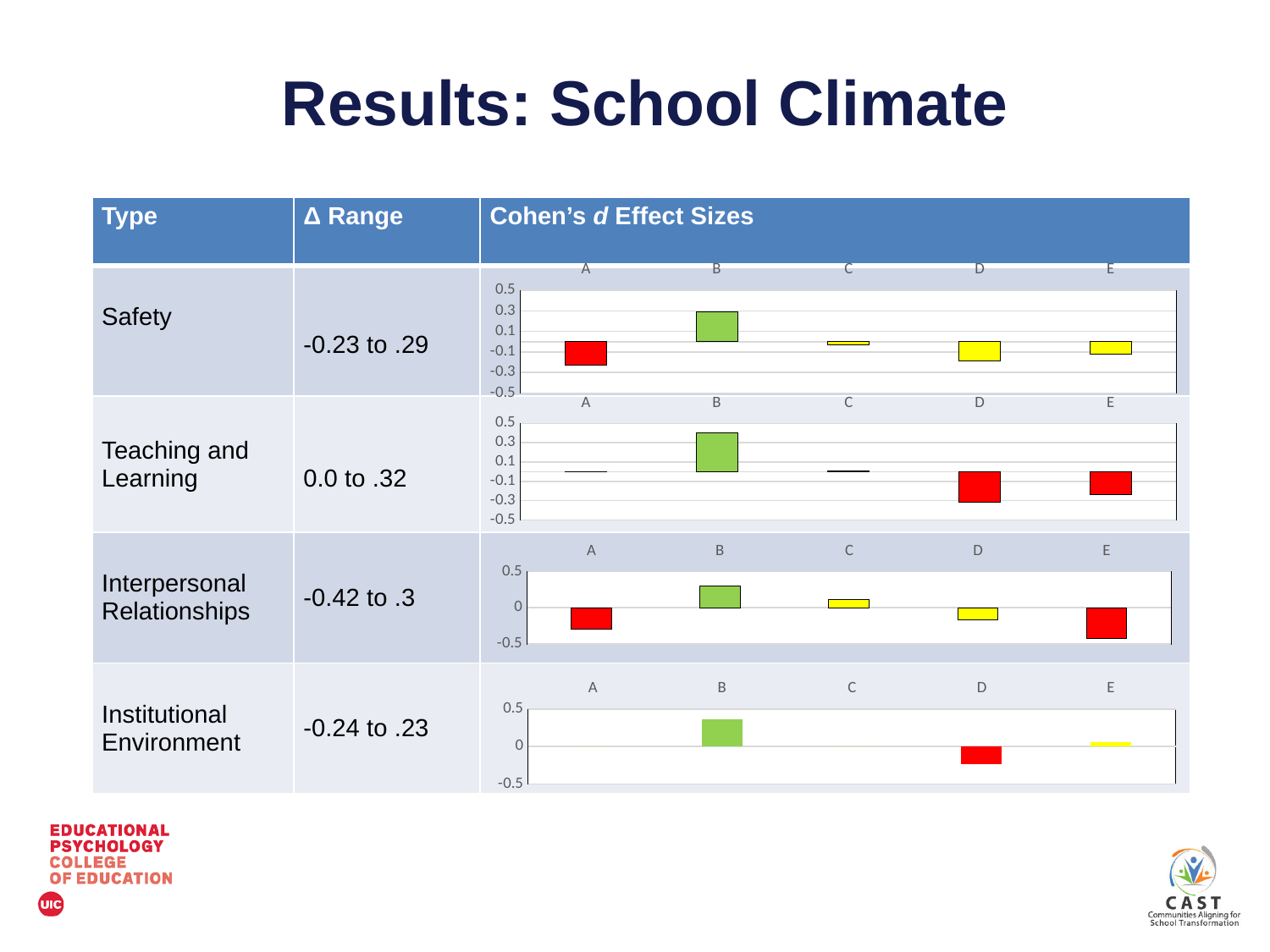
In the Safety chart, how many categories are shown on the x axis? 5 In the Safety chart, which category has the lowest value? A In the Interpersonal Relationships chart, which is larger, the value for A or the value for E? A In the Safety chart, which category has the highest value? B In the Safety chart, what colour is the bar for category B? green In the Interpersonal Relationships chart, which category has the lowest value? E In the Institutional Environment chart, is the value for B greater or less than 0? greater In the Safety chart, is the value for B greater or less than 0.1? greater In the Teaching and Learning chart, which category has the highest value? B In the Teaching and Learning chart, is the value for D greater or less than -0.1? less What kind of chart is shown in the Safety row? bar chart In the Institutional Environment chart, which category has the lowest value? D